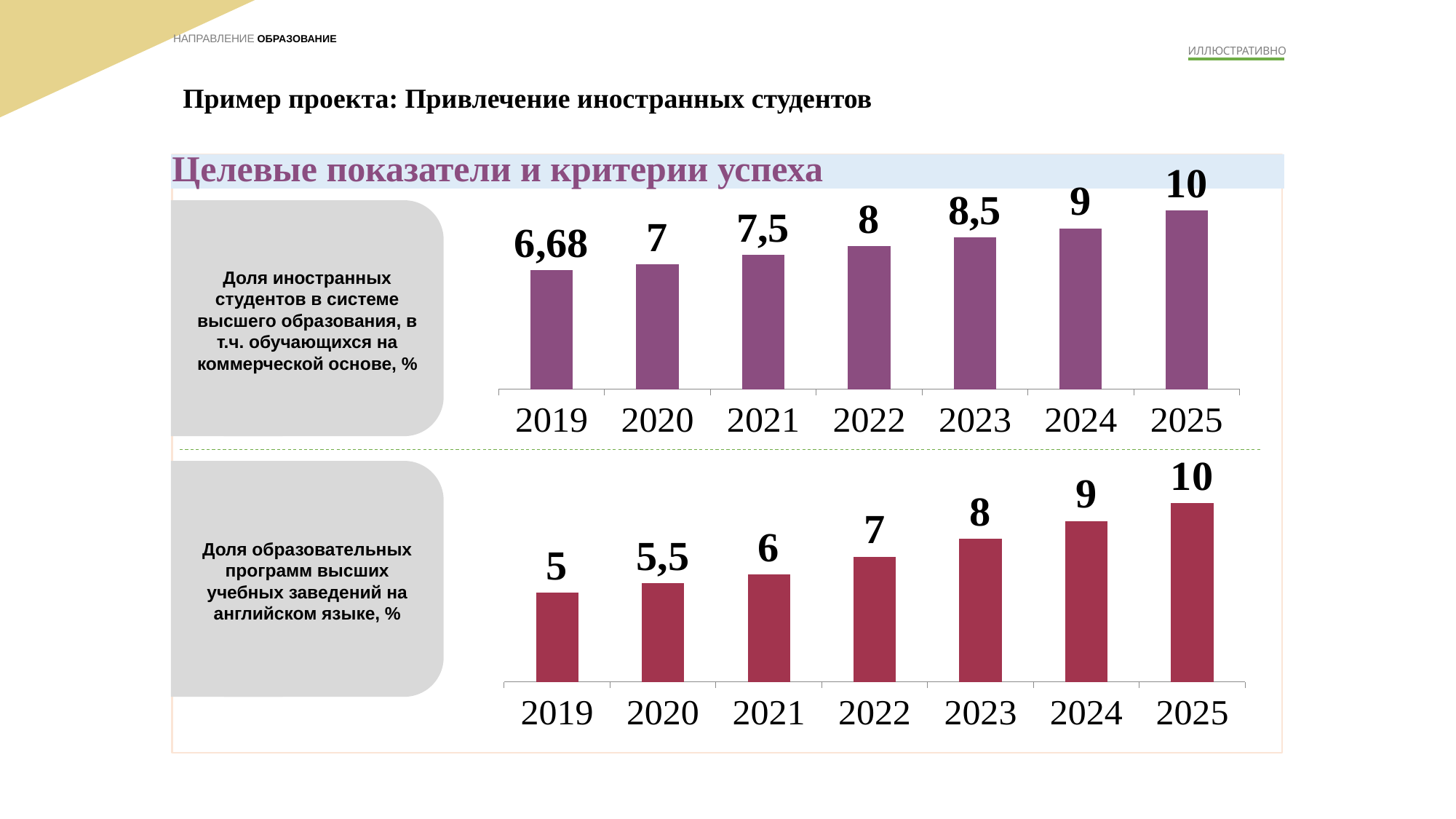
In the top chart (share of foreign students in higher education), which year has the highest value? 2025 In the top chart (share of foreign students in higher education), what is the value for 2019? 6,68 In the top chart (share of foreign students in higher education), what is the difference between the values for 2025 and 2019? 3,32 What type of chart is the top chart (share of foreign students in higher education)? Bar chart Which is larger: the 2021 value in the top chart or the 2021 value in the bottom chart? The top chart (7,5) How many years are shown on the x axis of the bottom chart (share of English-language educational programs)? 7 In the bottom chart (share of English-language educational programs), what is the value for 2022? 7 In the bottom chart (share of English-language educational programs), what is the difference between the values for 2024 and 2021? 3 In the bottom chart (share of English-language educational programs), what is the value for 2020? 5,5 In the bottom chart (share of English-language educational programs), do the values rise or fall from 2019 to 2025? Rise In the top chart (share of foreign students in higher education), what is the value for 2023? 8,5 In the bottom chart (share of English-language educational programs), which year has the lowest value? 2019